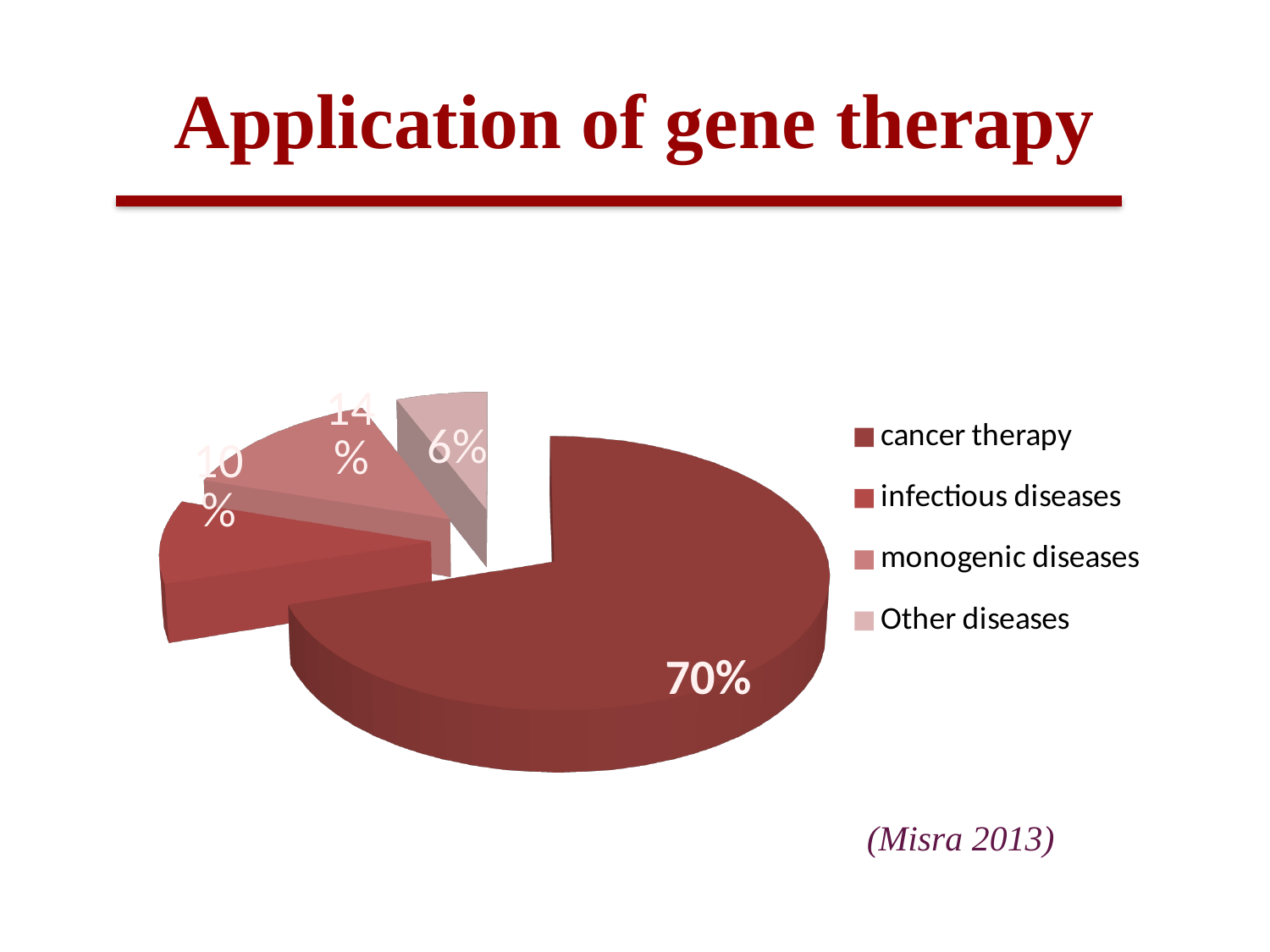
Which is larger, the slice for infectious diseases or the slice for monogenic diseases? monogenic diseases What kind of chart is shown on the slide? pie chart What share of the pie does infectious diseases account for? 10% What share of the pie does Other diseases account for? 6% Which legend entry is listed last? Other diseases What is the difference in percentage points between cancer therapy and monogenic diseases? 56 How many categories does the pie chart show? 4 Which category has the largest slice of the pie? cancer therapy What is the title of the slide containing the pie chart? Application of gene therapy What share of the pie does cancer therapy account for? 70% What share of the pie does monogenic diseases account for? 14% Which category has the smallest slice of the pie? Other diseases